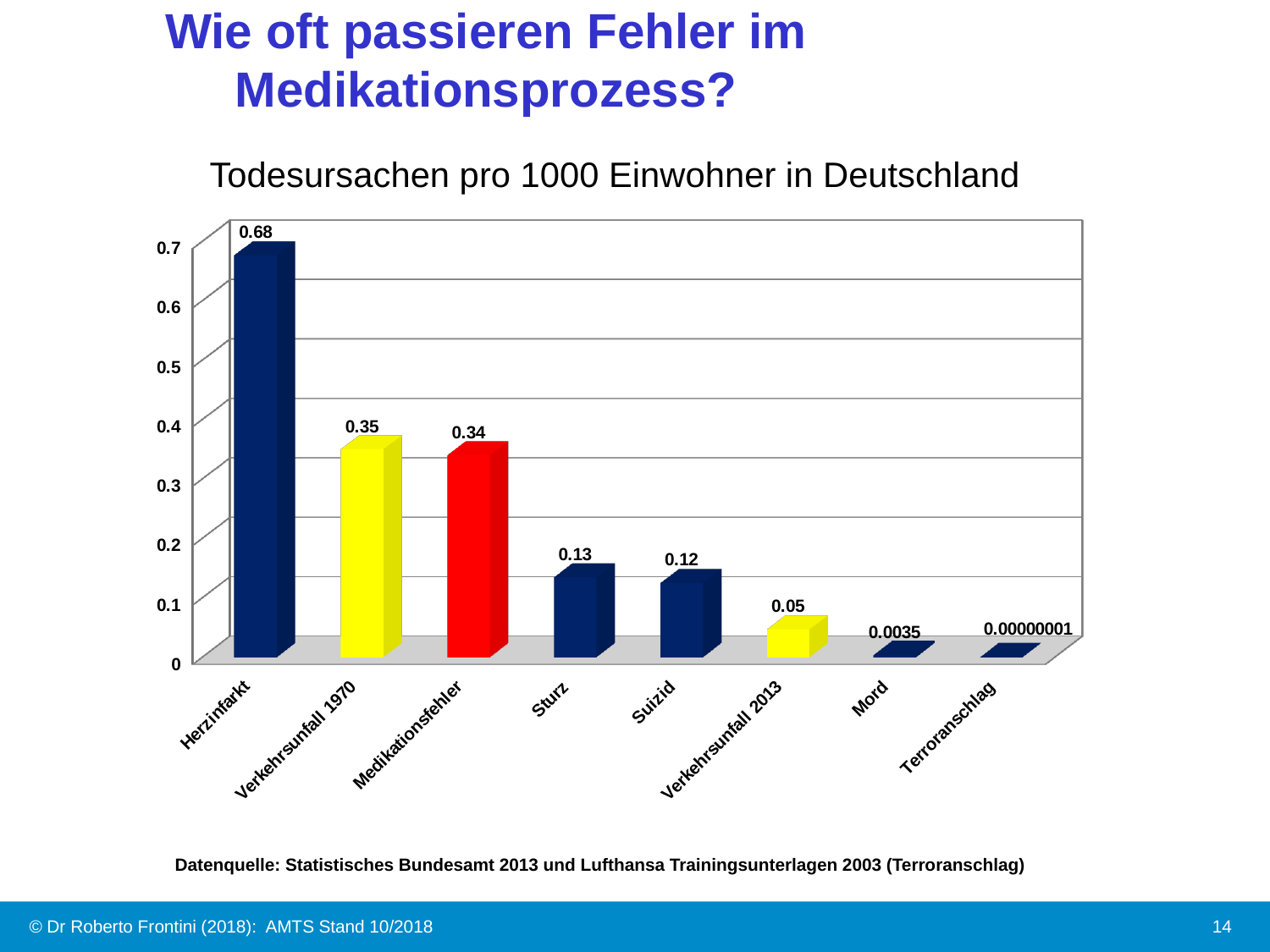
What is the difference between the values for Herzinfarkt and Medikationsfehler? 0.34 What kind of chart is shown on the slide? Bar chart Which category has the highest value? Herzinfarkt What is the difference between the values for Verkehrsunfall 1970 and Verkehrsunfall 2013? 0.3 Which category has the lowest value? Terroranschlag Which is larger, the value for Sturz or the value for Suizid? Sturz What is the value for Verkehrsunfall 2013? 0.05 What is the title of the chart? Todesursachen pro 1000 Einwohner in Deutschland How many categories are shown on the x axis? 8 What is the value for Mord? 0.0035 What is the value for Herzinfarkt? 0.68 What is the value for Medikationsfehler? 0.34